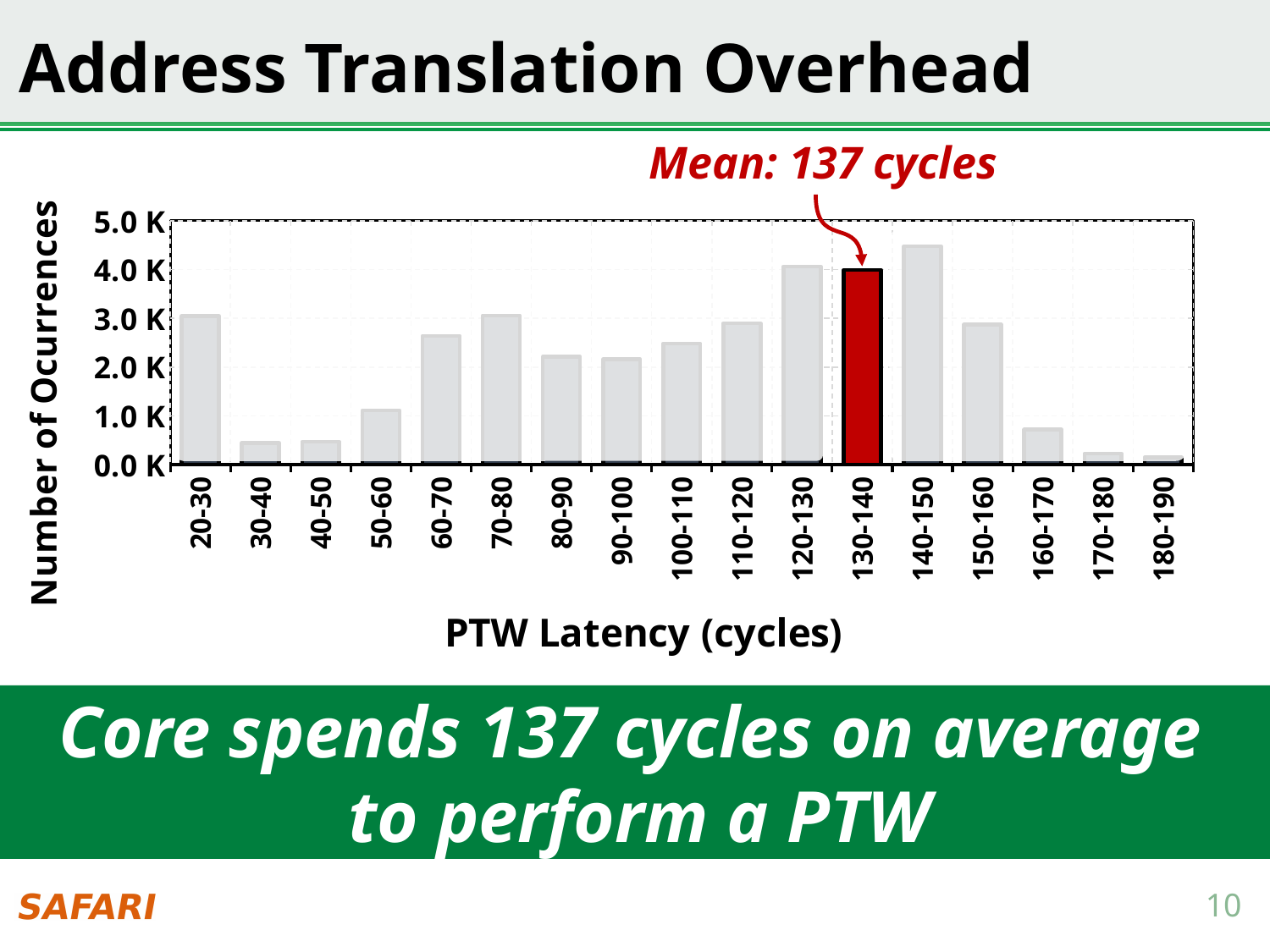
What kind of chart is shown on the slide? bar chart How many PTW latency bins are shown on the x axis? 17 Is the number of occurrences for the 60-70 bin greater or less than 2.0 K? greater What mean PTW latency is annotated on the chart? 137 cycles Which has more occurrences, the 40-50 bin or the 60-70 bin? 60-70 Which has more occurrences, the 120-130 bin or the 80-90 bin? 120-130 Is the number of occurrences for the 140-150 bin greater or less than 4.0 K? greater Which PTW latency bin is highlighted in red? 130-140 Is the number of occurrences for the 180-190 bin greater or less than 1.0 K? less Which PTW latency bin has the highest number of occurrences? 140-150